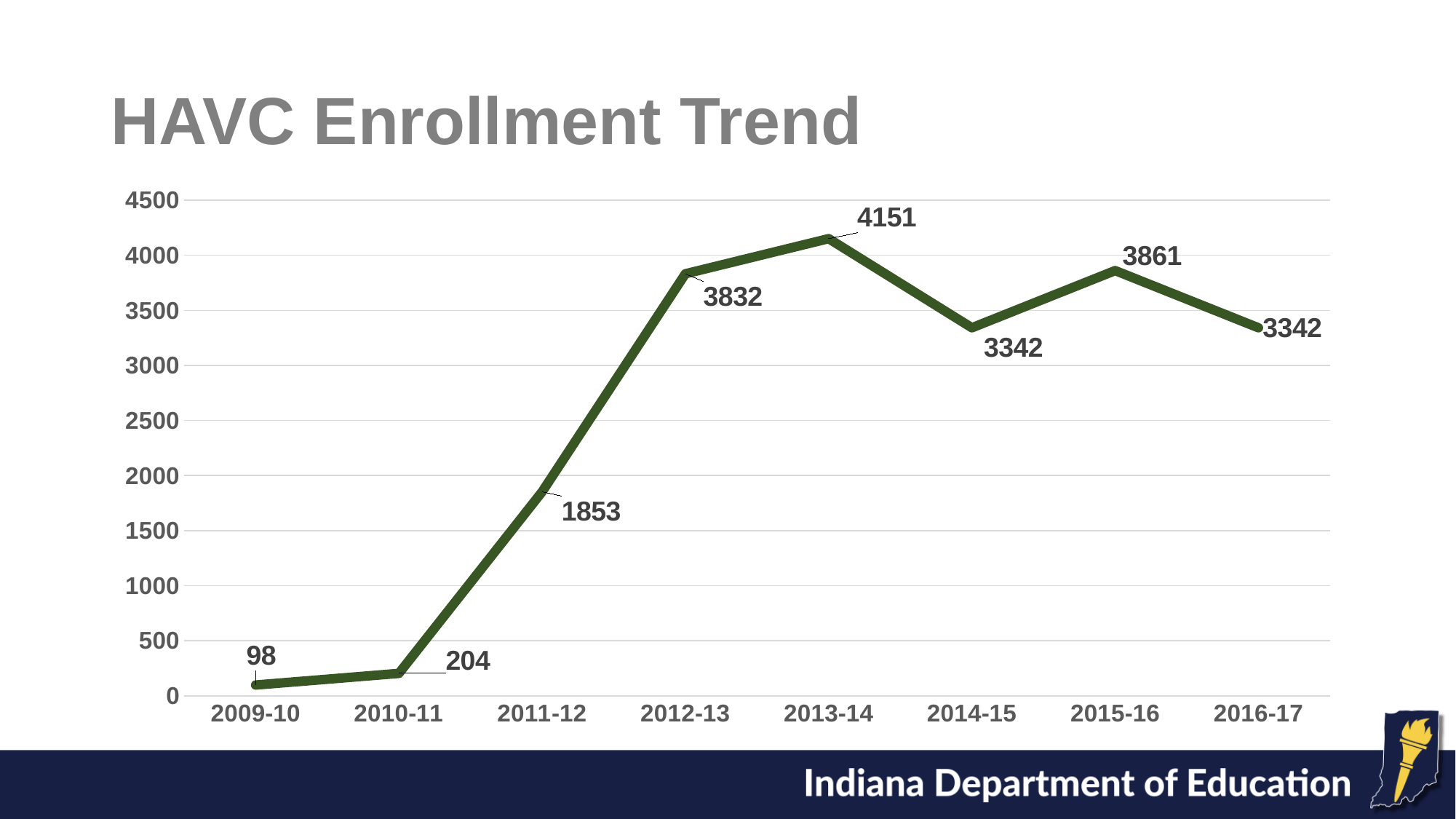
Is the enrollment value for 2014-15 greater or less than 3500? less What is the enrollment value for 2011-12? 1853 What kind of chart is shown on the slide? line chart What is the title of the chart? HAVC Enrollment Trend Which year has the highest enrollment? 2013-14 What is the difference in enrollment between 2015-16 and 2016-17? 519 What is the enrollment value for 2013-14? 4151 How many school years are plotted on the chart? 8 What is the enrollment value for 2009-10? 98 Which year has the lowest enrollment? 2009-10 What is the difference in enrollment between 2013-14 and 2012-13? 319 Which year has higher enrollment, 2012-13 or 2015-16? 2015-16